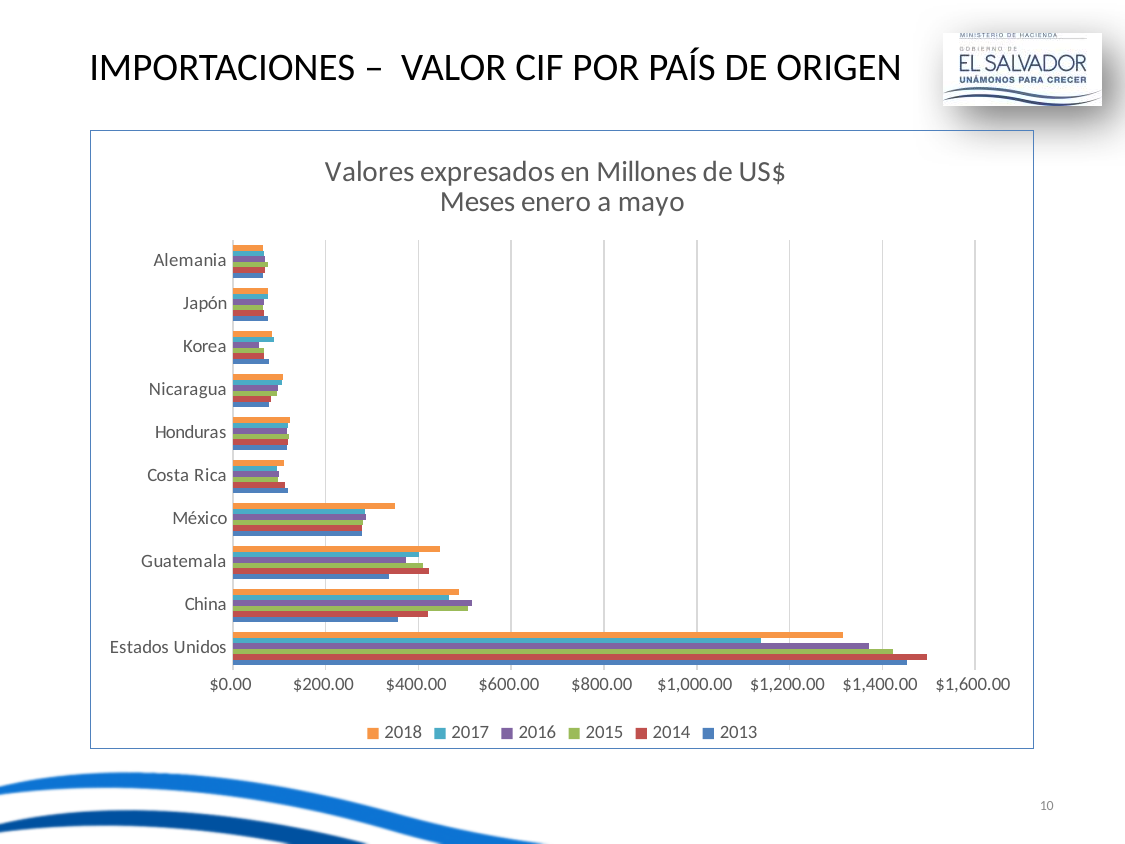
Is the 2018 value for México greater or less than $400.00? less Which country has the highest import value in the chart? Estados Unidos For Estados Unidos, which is larger: the 2014 value or the 2018 value? 2014 How many series does the legend list? 6 Is the 2018 value for China greater or less than $400.00? greater Is the 2018 value for Estados Unidos greater or less than $1,200.00? greater Which colour represents the 2018 series in the legend? orange How many countries are listed on the vertical axis of the chart? 10 For 2018, which is larger: the value for México or the value for Costa Rica? México What is the title of the chart? Valores expresados en Millones de US$ Meses enero a mayo What kind of chart is shown on the slide? bar chart